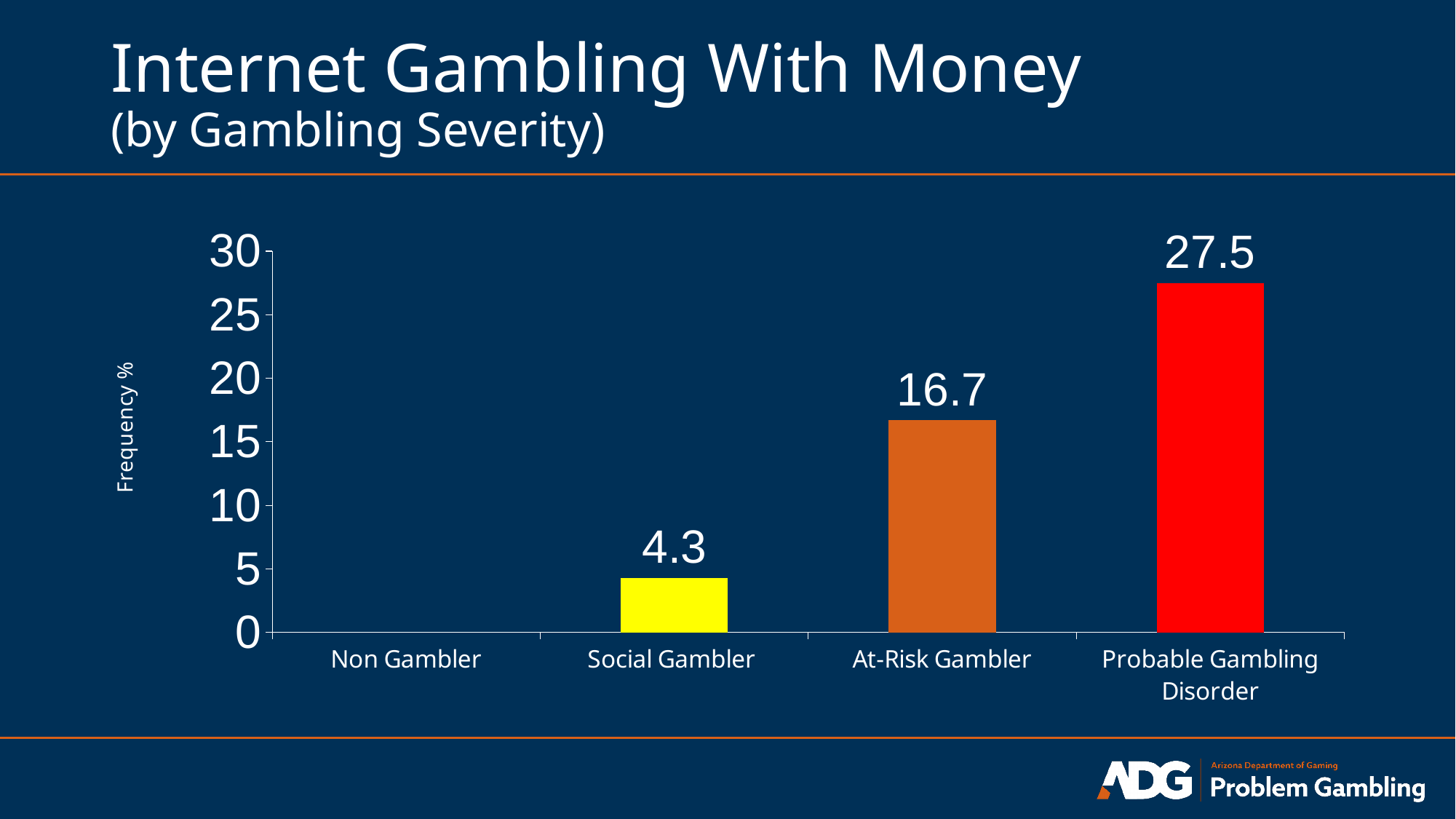
What is the value for At-Risk Gambler? 16.7 What is the difference between the values for Probable Gambling Disorder and At-Risk Gambler? 10.8 What is the difference between the values for At-Risk Gambler and Social Gambler? 12.4 What is the label of the y axis? Frequency % Which category has the highest value? Probable Gambling Disorder How many categories are shown on the x axis? 4 What is the value for Social Gambler? 4.3 Which is larger, the value for Social Gambler or the value for At-Risk Gambler? At-Risk Gambler What kind of chart is shown on the slide? bar chart What is the value for Probable Gambling Disorder? 27.5 Do the values rise or fall from left to right along the x axis? rise Is the value for Probable Gambling Disorder greater or less than 25? greater